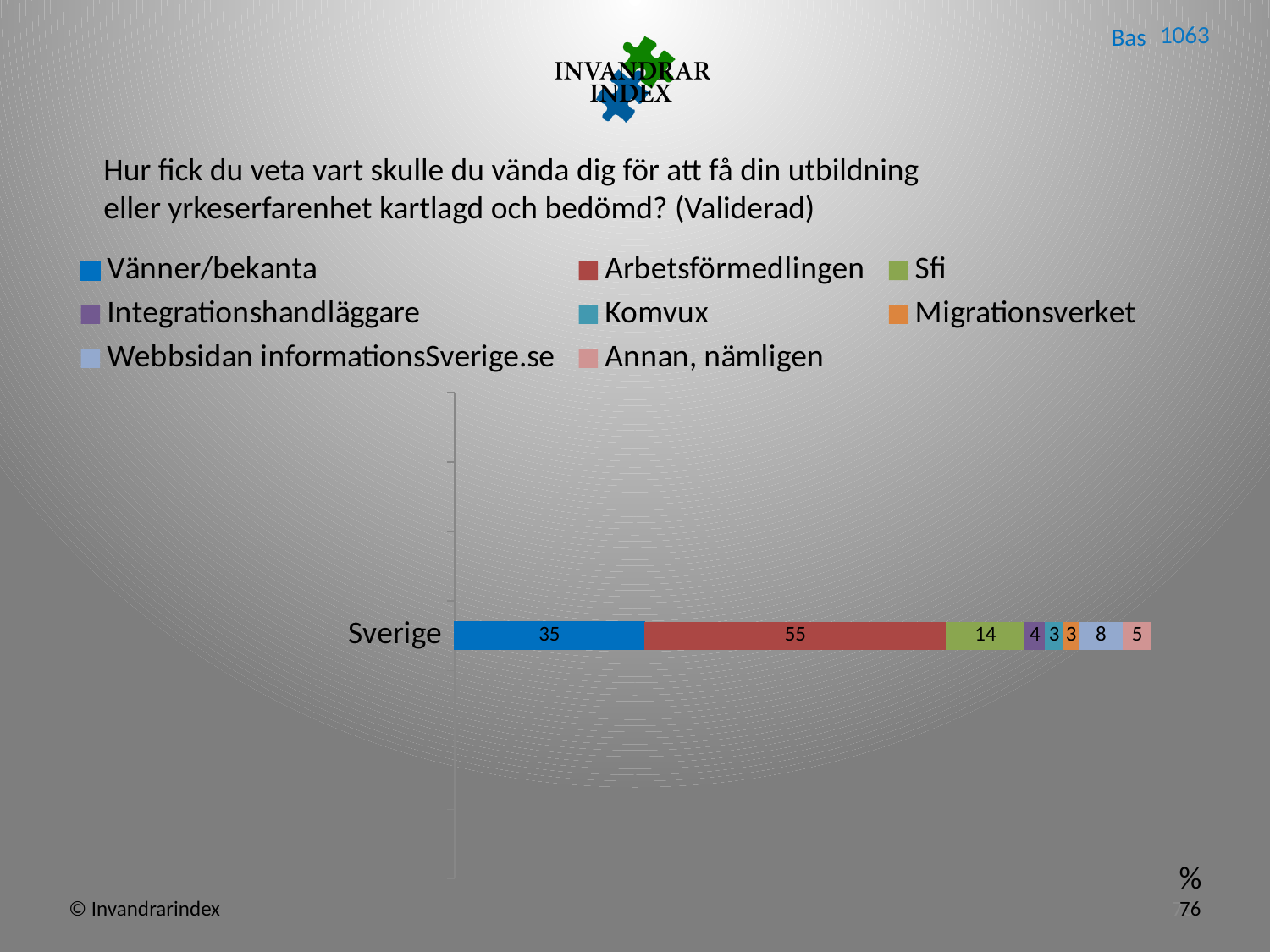
What is the value for Arbetsförmedlingen in the Sverige bar? 55 What is the value for Vänner/bekanta in the Sverige bar? 35 What is the value for Annan, nämligen in the Sverige bar? 5 Which category label is shown on the chart's axis? Sverige How many series does the legend list? 8 What is the total of the stacked Sverige bar? 127 Which is larger, the value for Sfi or the value for Webbsidan informationsSverige.se? Sfi What is the difference between the values for Arbetsförmedlingen and Vänner/bekanta? 20 What is the value for Webbsidan informationsSverige.se in the Sverige bar? 8 What kind of chart is shown on the slide? Stacked bar chart Which series has the highest value in the Sverige bar? Arbetsförmedlingen What is the value for Sfi in the Sverige bar? 14